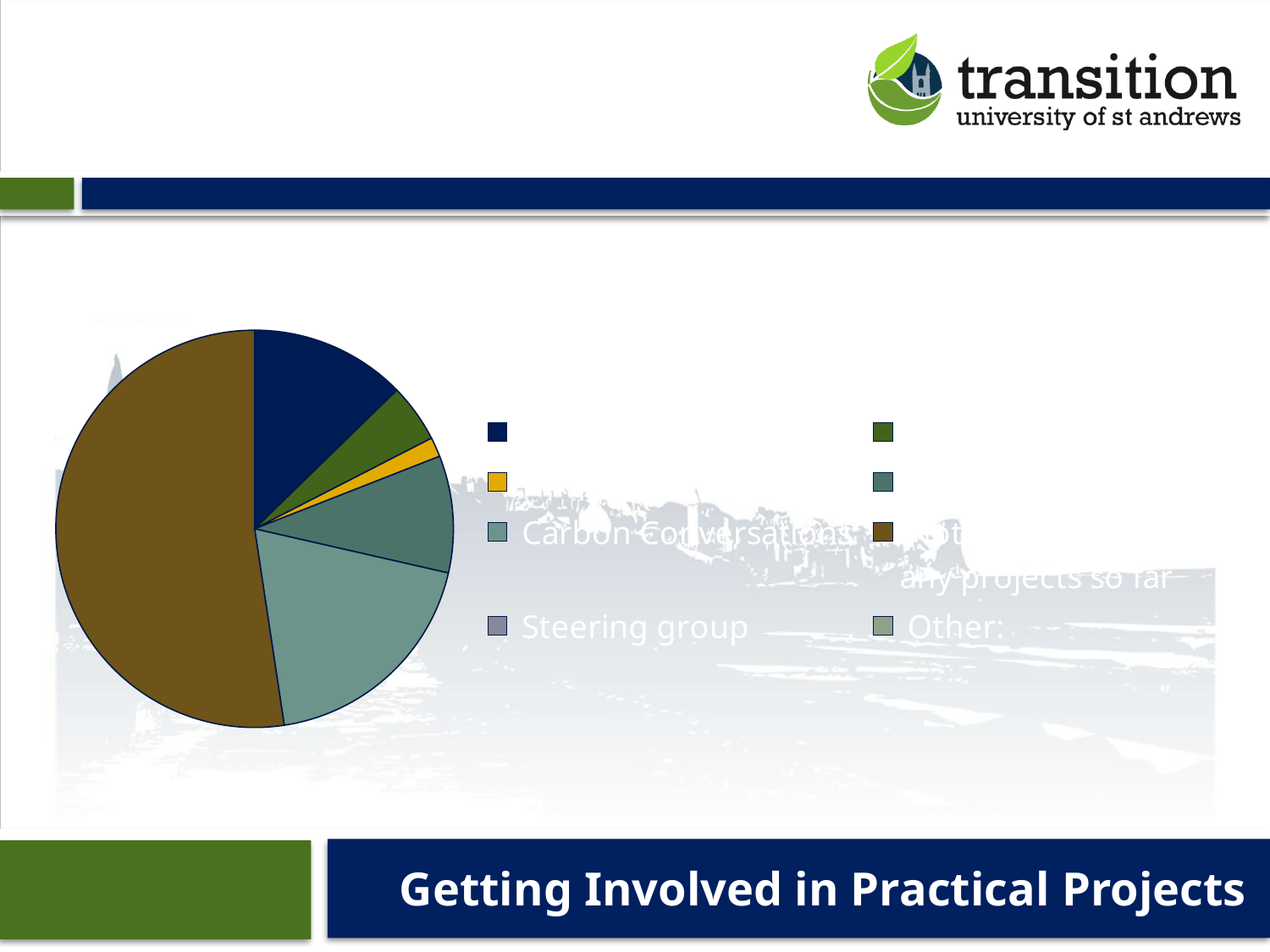
Which legend entry is shown with a light teal swatch in the pie chart's legend? Carbon Conversations Does the brown slice take up more or less than half of the pie chart? more What kind of chart is shown on the slide? pie chart How many slices does the pie chart have? 6 Which slice is larger in the pie chart, the brown slice or the light teal slice? brown Which colour slice is the smallest in the pie chart? yellow Which legend entry is shown with a grey-blue swatch in the pie chart's legend? Steering group How many entries does the legend of the pie chart list? 8 Which colour slice is the largest in the pie chart? brown Which slice is larger in the pie chart, the navy slice or the yellow slice? navy Which slice is larger in the pie chart, the green slice or the navy slice? navy